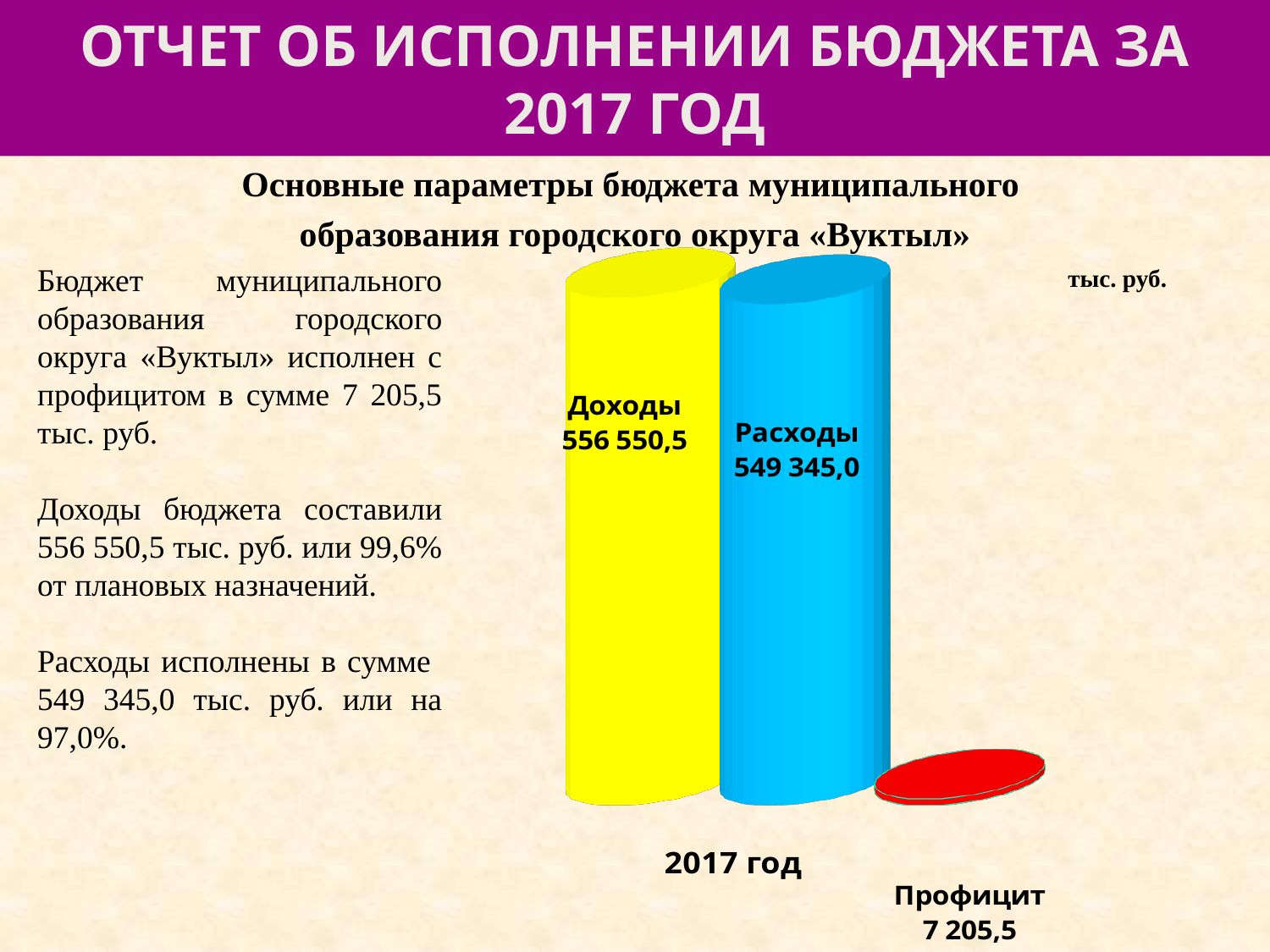
Which series has the highest value in the chart? Доходы Which is larger in the chart, Доходы or Расходы? Доходы What is the difference between Доходы and Расходы in the chart? 7 205,5 What is the value for Расходы in the chart? 549 345,0 What is the value for Доходы in the chart? 556 550,5 Which is larger in the chart, Расходы or Профицит? Расходы What kind of chart is shown on the slide? Bar chart What year is shown on the x axis of the chart? 2017 год What unit is indicated for the values in the chart? тыс. руб. How many bars are plotted in the chart? 3 Which series has the lowest value in the chart? Профицит What is the value for Профицит in the chart? 7 205,5